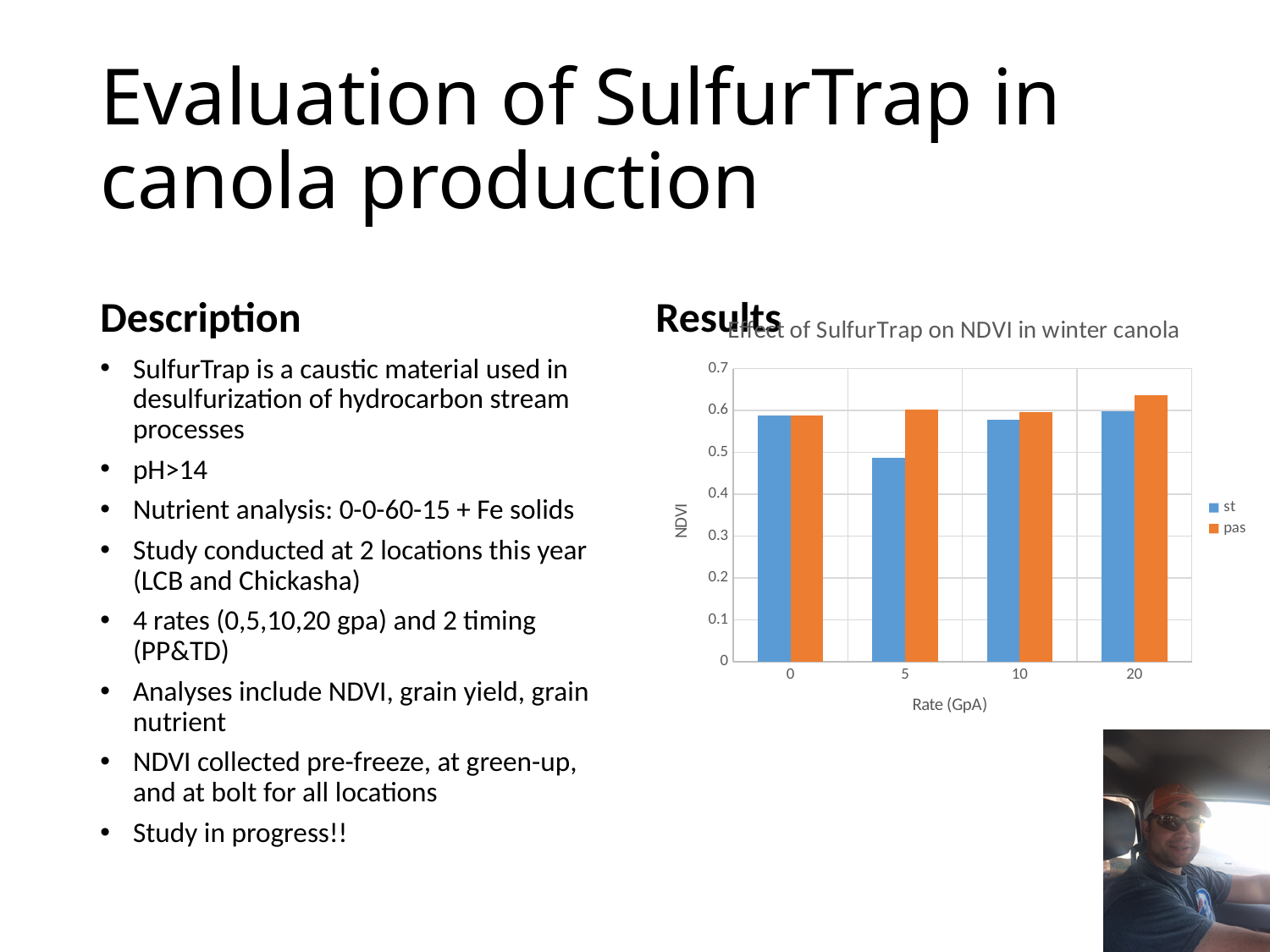
How many rate categories are shown on the x axis of the chart? 4 Is the value for the pas series at rate 20 greater or less than 0.6? greater What is the title of the chart? Effect of SulfurTrap on NDVI in winter canola At which rate is the st series lowest? 5 Is the value for the st series at rate 5 greater or less than 0.5? less At rate 20, which series has the larger value, st or pas? pas What is the label of the y axis of the chart? NDVI At which rate is the pas series highest? 20 How many series does the chart legend list? 2 What kind of chart is shown on the slide? bar chart Is the value for the st series at rate 0 greater or less than 0.5? greater At rate 5, which series has the larger value, st or pas? pas